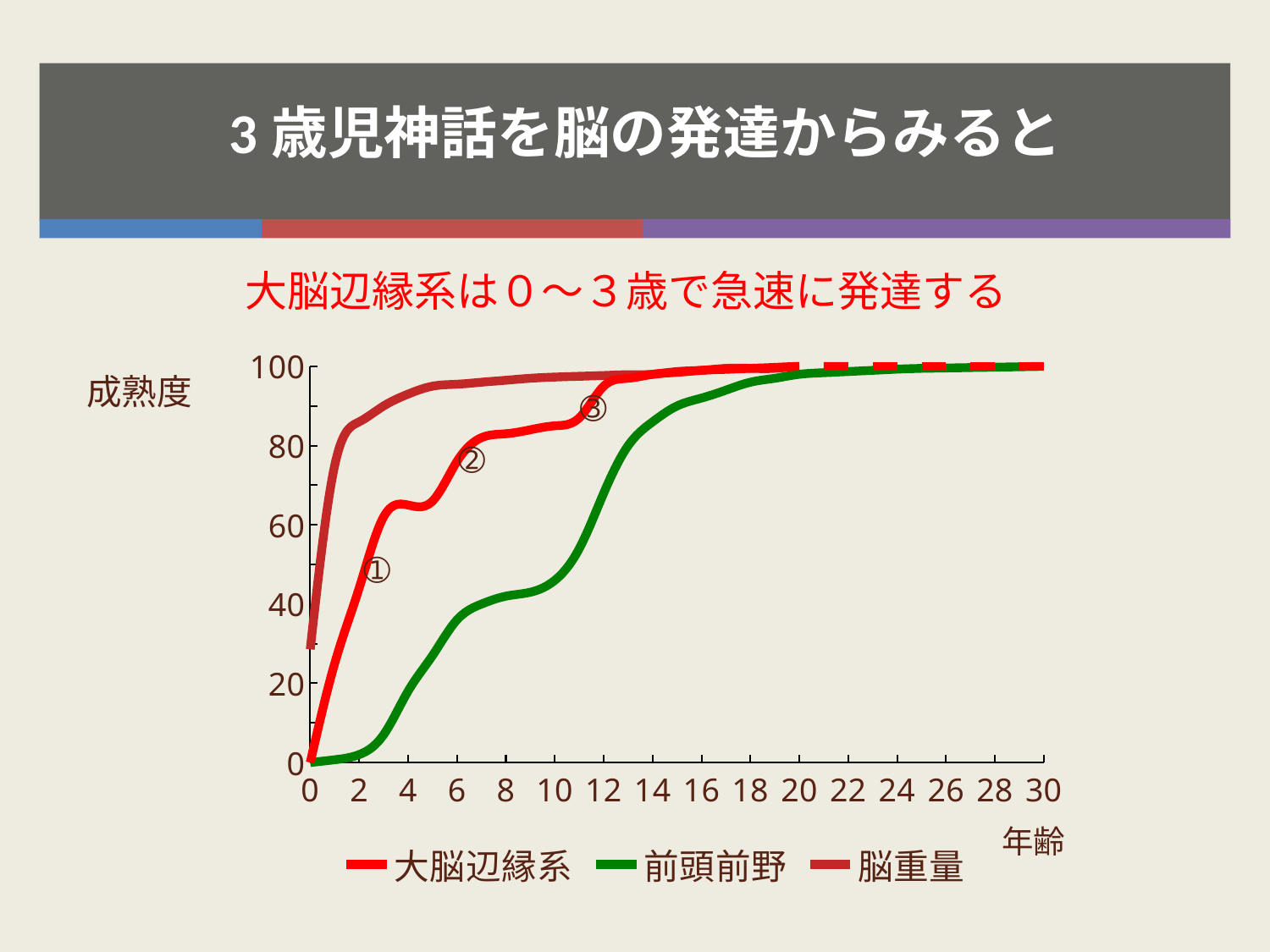
What kind of chart is shown on the slide? line chart How many series does the legend list? 3 Which series does the green line represent? 前頭前野 At age 2, which is larger: 脳重量 or 大脳辺縁系? 脳重量 What is the label of the vertical axis? 成熟度 Is the value for 大脳辺縁系 at age 2 greater or less than 60? less Is the value for 大脳辺縁系 at age 12 greater or less than 80? greater At age 6, which is larger: 大脳辺縁系 or 前頭前野? 大脳辺縁系 Does the 前頭前野 line rise or fall as age increases from 0 to 30? rise Which series has the lowest value at age 8? 前頭前野 Is the value for 前頭前野 at age 10 greater or less than 60? less